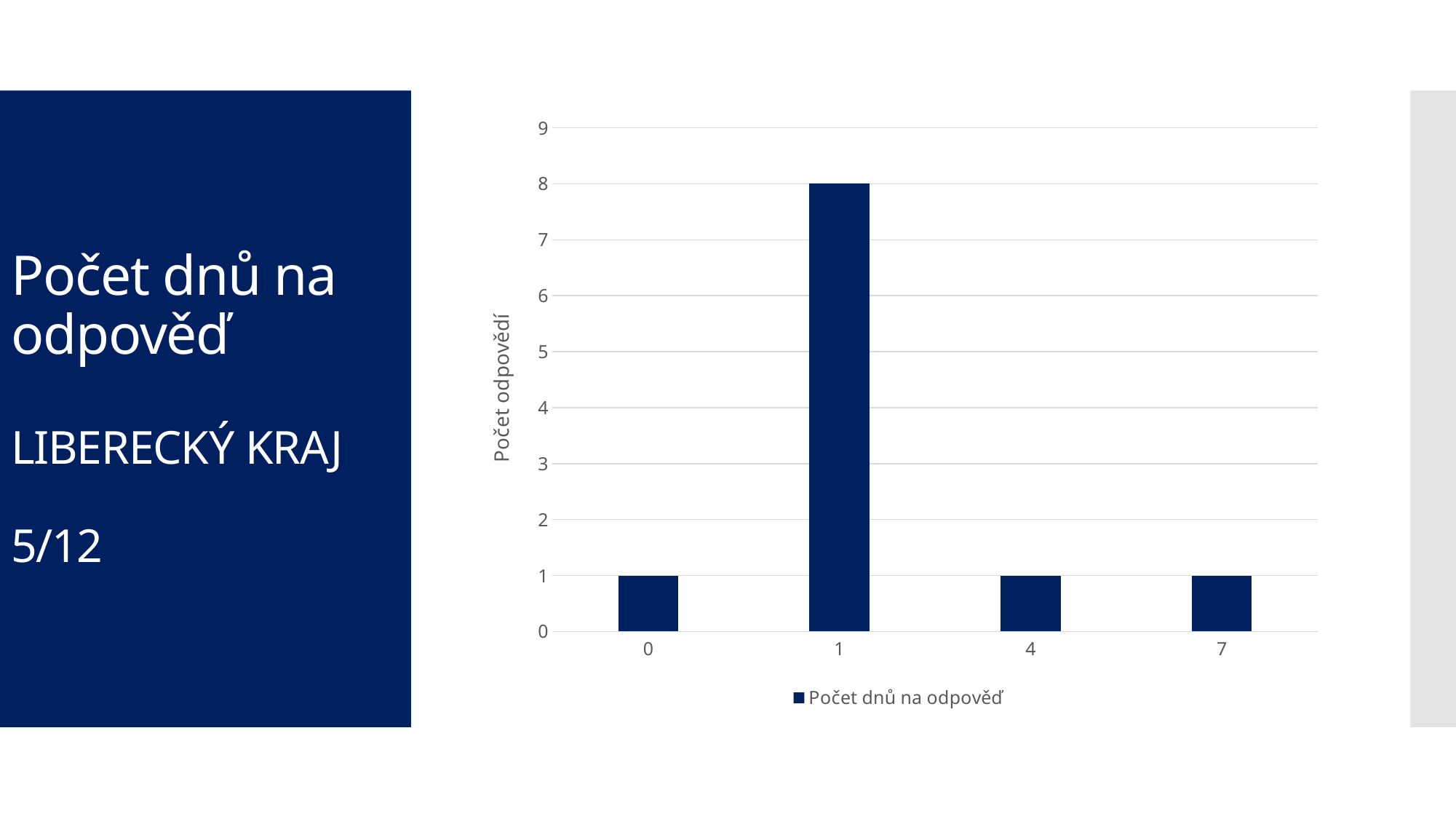
What is the value for category 7 in the chart? 1 Which has the larger value, category 1 or category 7? 1 What is the label of the series in the chart legend? Počet dnů na odpověď What type of chart is shown on the slide? bar chart Which category has the highest value in the chart? 1 Is the value for category 1 greater or less than 5? greater What is the title of the vertical axis of the chart? Počet odpovědí What is the difference between the value for category 1 and the value for category 4? 7 How many series does the chart legend list? 1 What is the value for category 0 in the chart? 1 How many categories are shown on the x axis of the chart? 4 What is the value for category 1 in the chart? 8